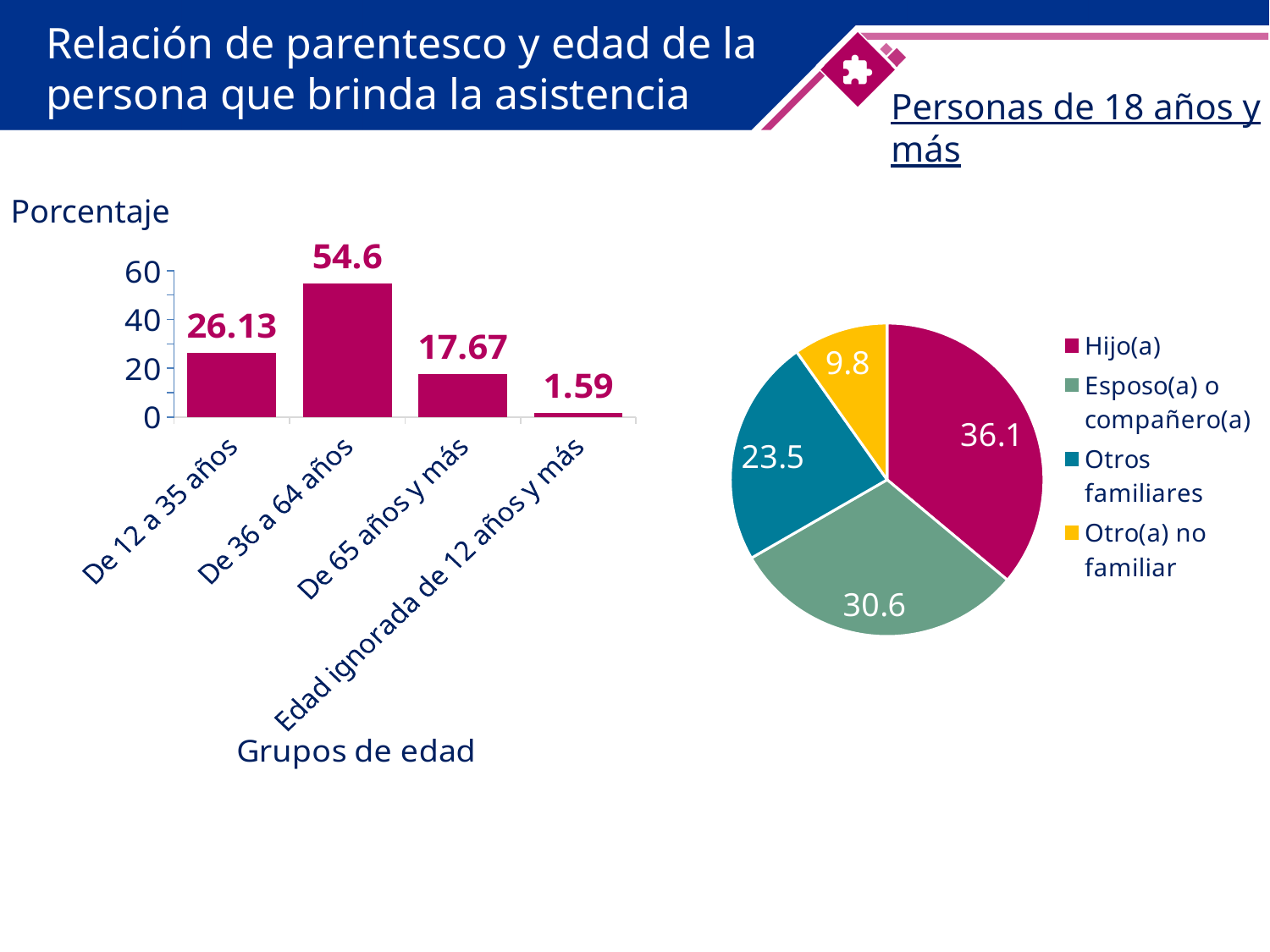
In the pie chart on the right, what is the value for Otros familiares? 23.5 In the bar chart on the left, which age group has the lowest value? Edad ignorada de 12 años y más In the pie chart on the right, which is larger: Esposo(a) o compañero(a) or Otro(a) no familiar? Esposo(a) o compañero(a) In the bar chart on the left, which age group has the highest value? De 36 a 64 años In the bar chart on the left, what is the value for De 12 a 35 años? 26.13 What kind of chart is the chart on the left of the slide? Bar chart In the bar chart on the left, how many age groups are shown? 4 In the pie chart on the right, which category has the largest slice? Hijo(a) How many categories does the legend of the pie chart on the right list? 4 In the bar chart on the left, what is the label of the x axis? Grupos de edad In the bar chart on the left, what is the difference between the values for De 36 a 64 años and De 65 años y más? 36.93 In the bar chart on the left, what is the value for De 36 a 64 años? 54.6